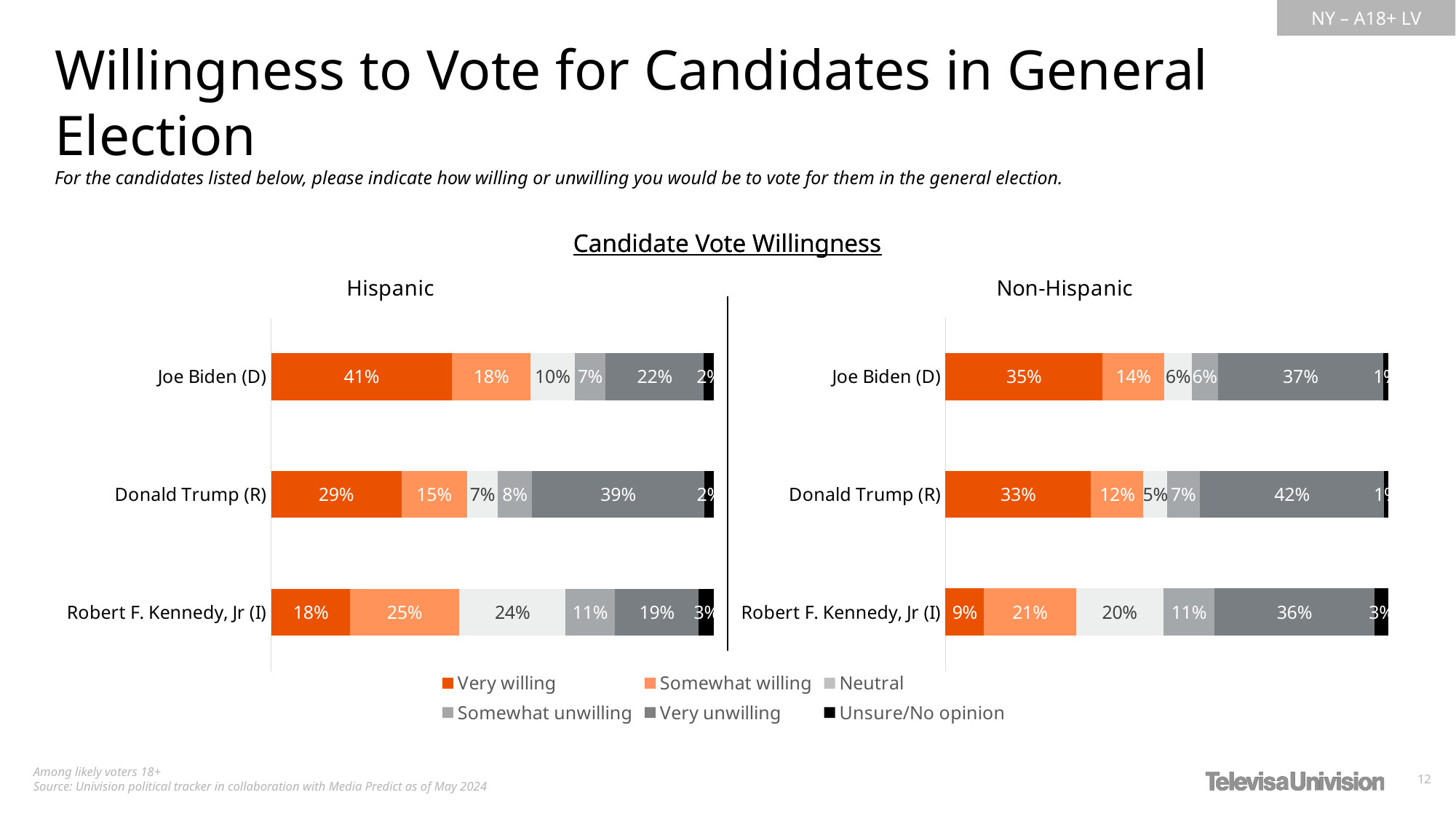
In the Non-Hispanic chart, what percentage of respondents are Very unwilling to vote for Donald Trump (R)? 42% In the Hispanic chart, what percentage of respondents are Very willing to vote for Joe Biden (D)? 41% In the Non-Hispanic chart, what is the Somewhat willing percentage for Robert F. Kennedy, Jr (I)? 21% In the Hispanic chart, what is the Neutral percentage for Robert F. Kennedy, Jr (I)? 24% In the Hispanic chart, which candidate has the highest Very willing percentage? Joe Biden (D) What is the title shown above the two charts? Candidate Vote Willingness In the Non-Hispanic chart, which candidate has the lowest Very willing percentage? Robert F. Kennedy, Jr (I) In the Hispanic chart, how many percentage points higher is the Very unwilling share for Donald Trump (R) than for Joe Biden (D)? 17 percentage points What type of chart is used to show Candidate Vote Willingness? Stacked bar chart How many response categories does the legend list? 6 In the Non-Hispanic chart, who has the larger Somewhat willing percentage, Joe Biden (D) or Donald Trump (R)? Joe Biden (D) How many candidates are shown in the Hispanic chart? 3